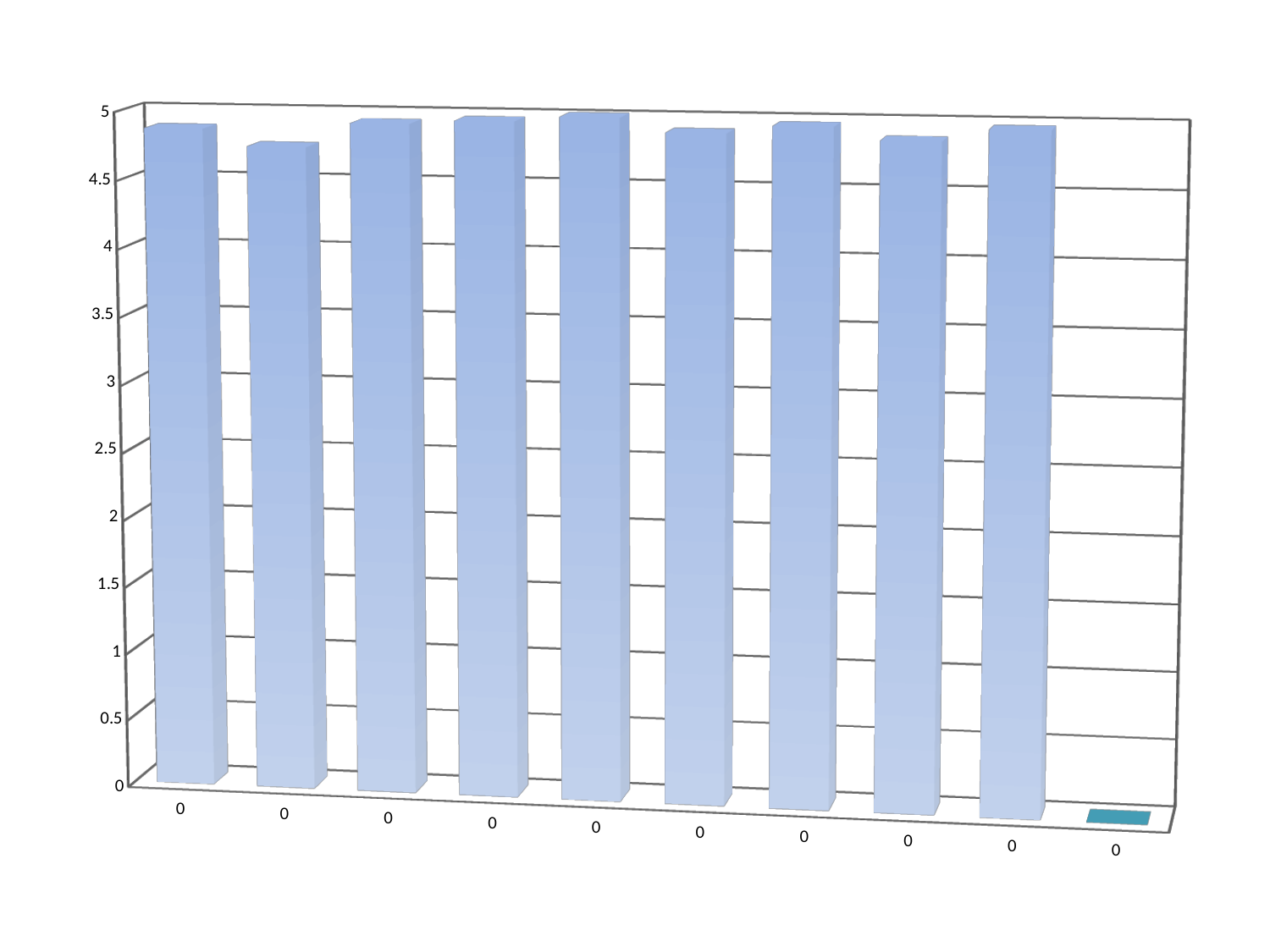
Which is larger, the second bar from the left or the fifth bar from the left? the fifth bar from the left What kind of chart is shown on the slide? bar chart Which is larger, the first bar from the left or the rightmost bar? the first bar from the left What is the highest value shown on the vertical axis? 5 What label appears beneath each bar on the horizontal axis? 0 Is the value of the rightmost bar greater or less than 0.5? less How many bars have values greater than 4? 9 How many bars are plotted in the chart? 10 Which bar has the lowest value? the rightmost (tenth) bar Is the value of the second bar from the left greater or less than 4? greater Is the value of the fifth bar from the left greater or less than 4.5? greater